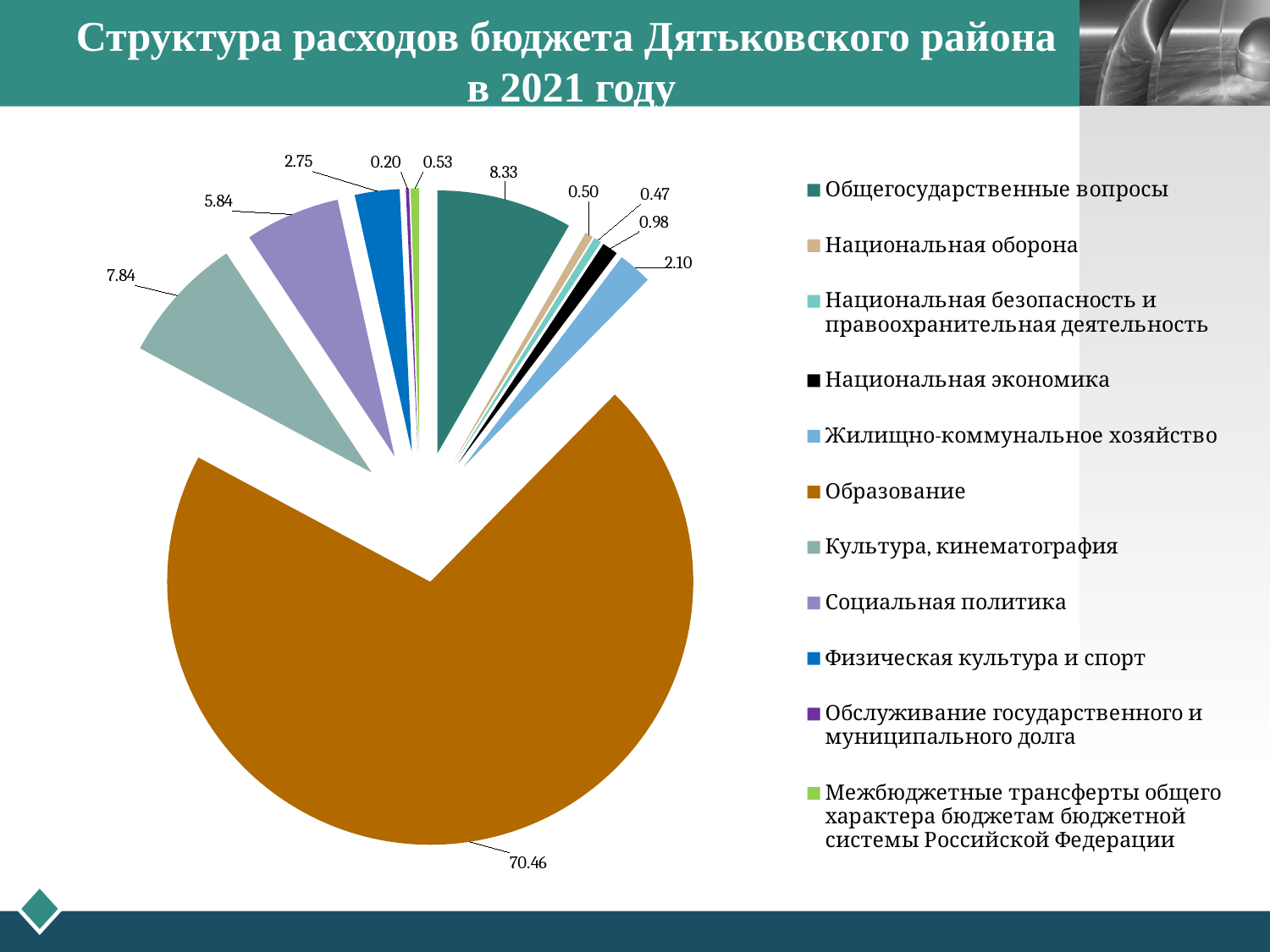
Which category has the largest slice of the pie? Образование What is the value for Образование? 70.46 What is the value for Культура, кинематография? 7.84 How many categories does the legend list? 11 What type of chart is shown on the slide? Pie chart Which is larger, the value for Физическая культура и спорт or the value for Национальная экономика? Физическая культура и спорт What is the value for Общегосударственные вопросы? 8.33 What is the title of the chart on the slide? Структура расходов бюджета Дятьковского района в 2021 году What is the value for Жилищно-коммунальное хозяйство? 2.10 What is the value for Социальная политика? 5.84 Which category has the smallest slice of the pie? Обслуживание государственного и муниципального долга What is the difference between the values for Общегосударственные вопросы and Культура, кинематография? 0.49